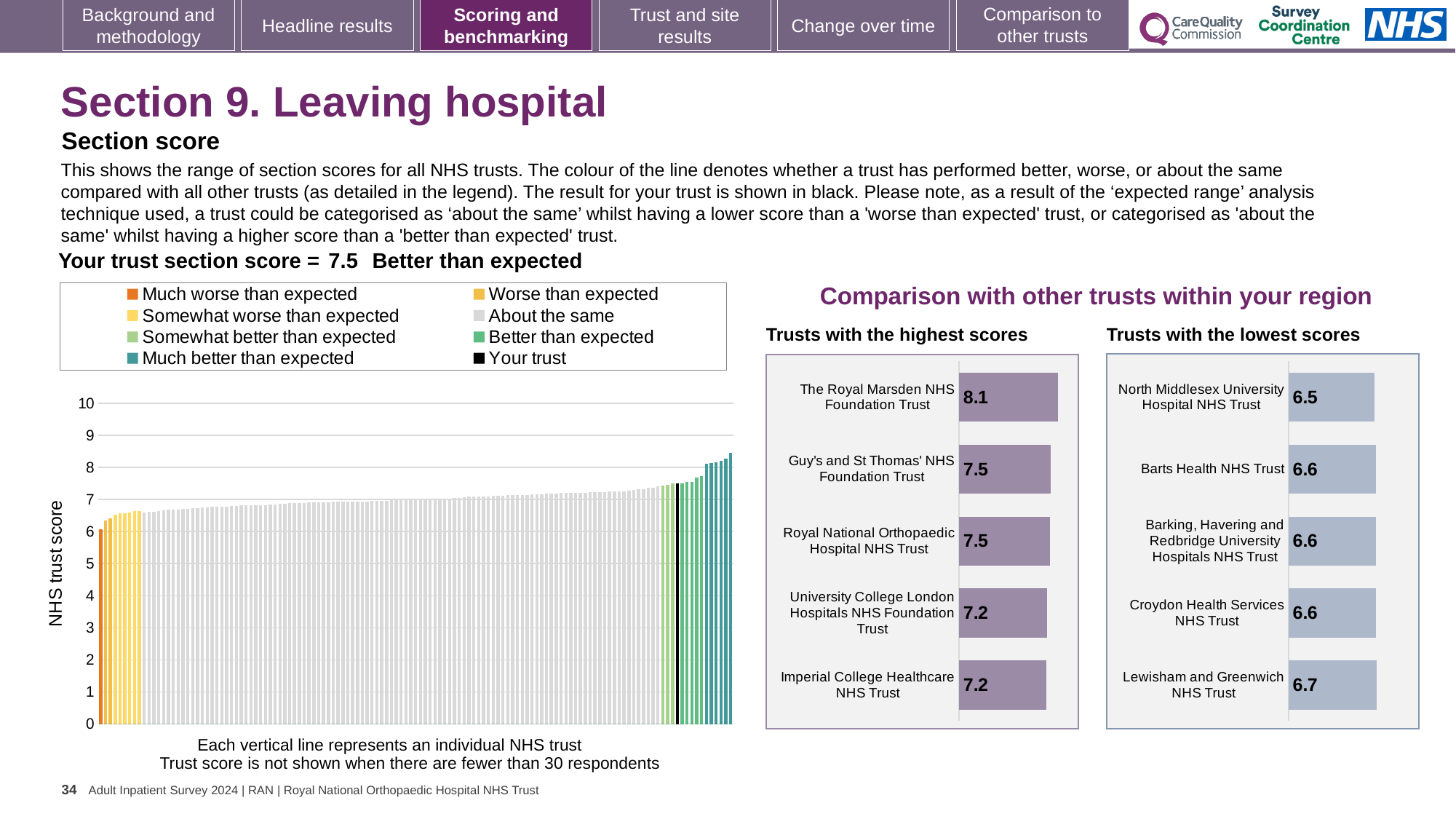
In the 'Trusts with the lowest scores' chart, which has the larger score: Lewisham and Greenwich NHS Trust or North Middlesex University Hospital NHS Trust? Lewisham and Greenwich NHS Trust In the 'Trusts with the highest scores' chart, what is the difference between the scores of The Royal Marsden NHS Foundation Trust and Imperial College Healthcare NHS Trust? 0.9 In the 'Trusts with the lowest scores' chart, which trust has the lowest score? North Middlesex University Hospital NHS Trust How many trusts are shown in the 'Trusts with the highest scores' chart? 5 In the large chart on the left, is the value of the black bar (your trust) greater or less than 7? greater In the 'Trusts with the highest scores' chart, what is the score for The Royal Marsden NHS Foundation Trust? 8.1 What kind of chart is the large chart on the left showing NHS trust scores? Bar chart In the 'Trusts with the highest scores' chart, which trust has the highest score? The Royal Marsden NHS Foundation Trust How many entries does the legend of the large chart on the left list? 8 In the large chart on the left, do the trust scores rise or fall from left to right? Rise In the 'Trusts with the lowest scores' chart, what is the score for North Middlesex University Hospital NHS Trust? 6.5 In the 'Trusts with the lowest scores' chart, what is the score for Lewisham and Greenwich NHS Trust? 6.7